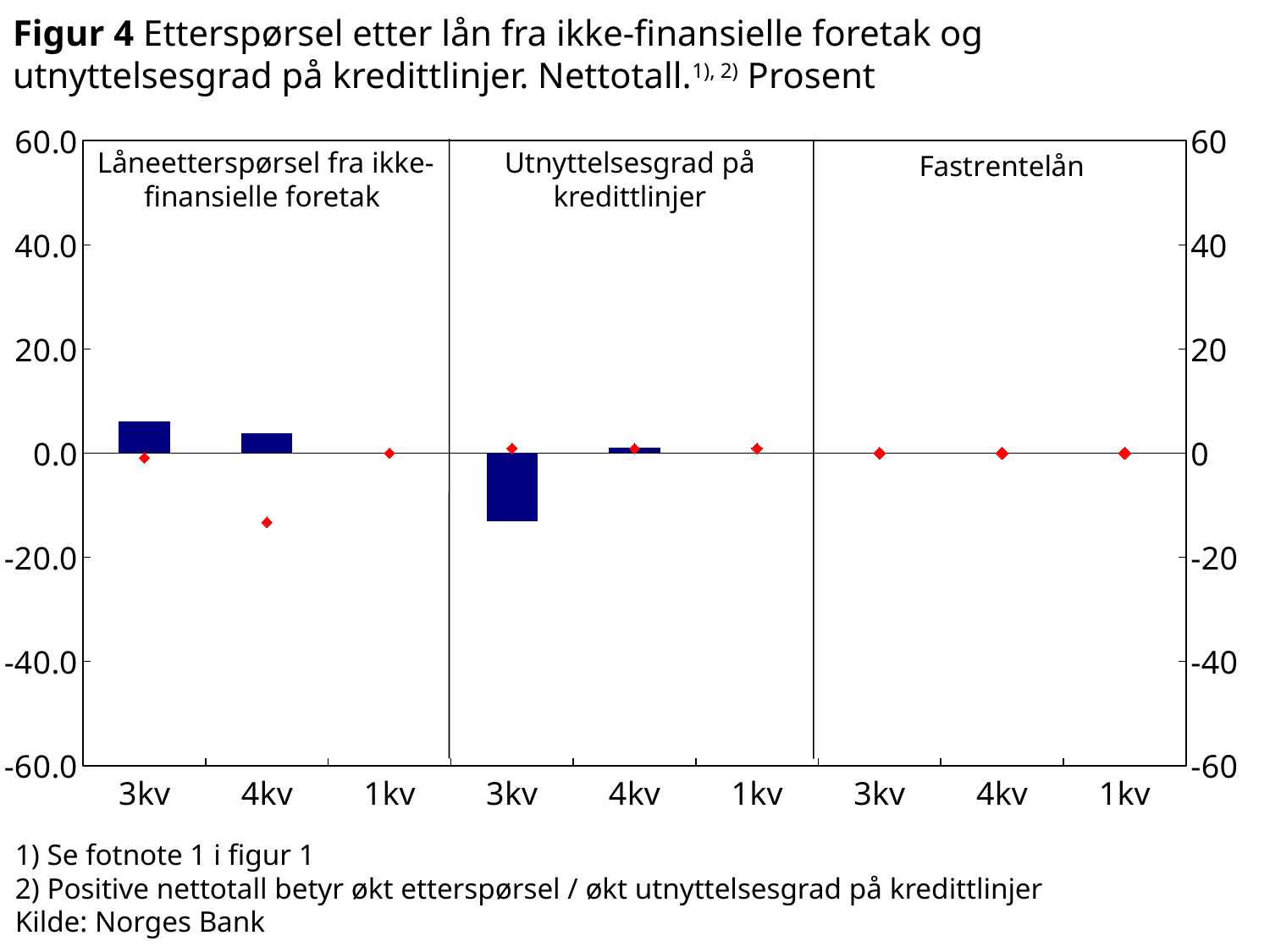
In the 'Låneetterspørsel fra ikke-finansielle foretak' panel, which bar is larger, 3kv or 4kv? 3kv In the 'Utnyttelsesgrad på kredittlinjer' panel, is the bar for 3kv greater or less than 0? less In the 'Låneetterspørsel fra ikke-finansielle foretak' panel, is the bar for 3kv greater or less than 20? less In the 'Låneetterspørsel fra ikke-finansielle foretak' panel, do the bars rise or fall from 3kv to 1kv? fall What is the source cited below the chart? Norges Bank How many panels (sections) does the chart have? 3 What kind of chart is shown on the slide? combination bar and line chart (bars with red diamond markers) In the 'Utnyttelsesgrad på kredittlinjer' panel, which quarter has the lowest bar? 3kv In the 'Utnyttelsesgrad på kredittlinjer' panel, is the bar for 3kv greater or less than -20? greater How many quarters are shown on the x axis within each panel? 3